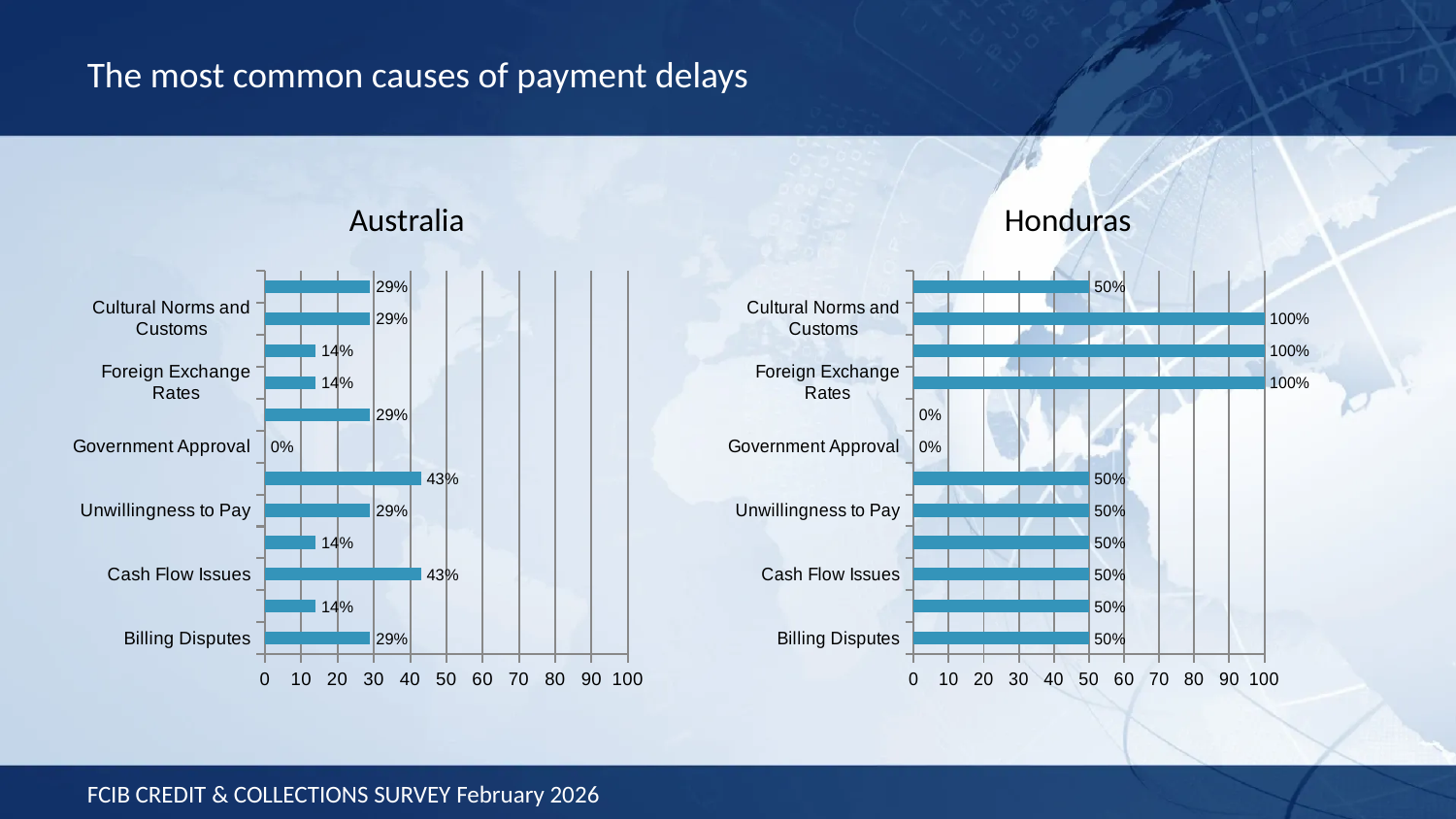
In the Australia chart, what is the difference between Cash Flow Issues and Billing Disputes? 14 percentage points In the Australia chart, what is the highest value shown on any bar? 43% In the Australia chart, what is the value for Billing Disputes? 29% What kind of chart is the Australia chart? bar chart In the Honduras chart, what is the value for Billing Disputes? 50% In the Honduras chart, which is larger: Unwillingness to Pay or Government Approval? Unwillingness to Pay In the Honduras chart, which labeled category has the lowest value? Government Approval What is the title of the slide? The most common causes of payment delays In the Australia chart, what is the value for Cash Flow Issues? 43% In the Honduras chart, what is the value for Government Approval? 0% In the Australia chart, what is the value for Government Approval? 0% In the Australia chart, is the value for Cash Flow Issues greater or less than 40? greater